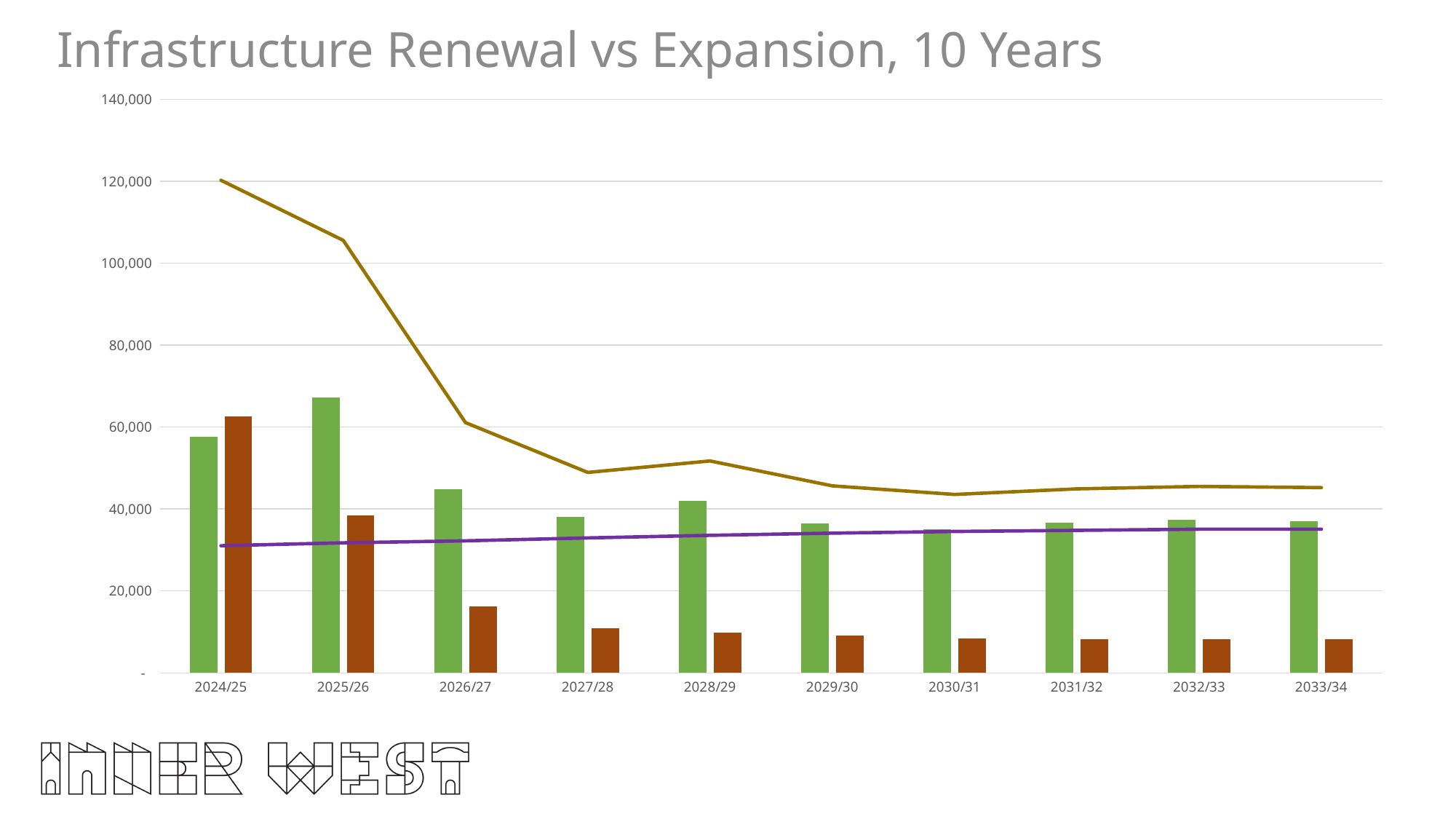
Does the purple line rise or fall from 2024/25 to 2033/34? Rise What kind of chart is this? Combined bar and line chart Does the gold line generally rise or fall from 2024/25 to 2033/34? Fall How many years are shown on the x axis? 10 In 2026/27, which bar is taller, the green bar or the brown bar? The green bar Which year has the tallest brown bar? 2024/25 Is the value of the brown bar in 2026/27 greater or less than 20,000? less Which year has the tallest green bar? 2025/26 Is the value of the green bar in 2025/26 greater or less than 60,000? greater In 2024/25, which bar is taller, the green bar or the brown bar? The brown bar Is the value of the gold line in 2024/25 greater or less than 100,000? greater What is the title of the chart? Infrastructure Renewal vs Expansion, 10 Years